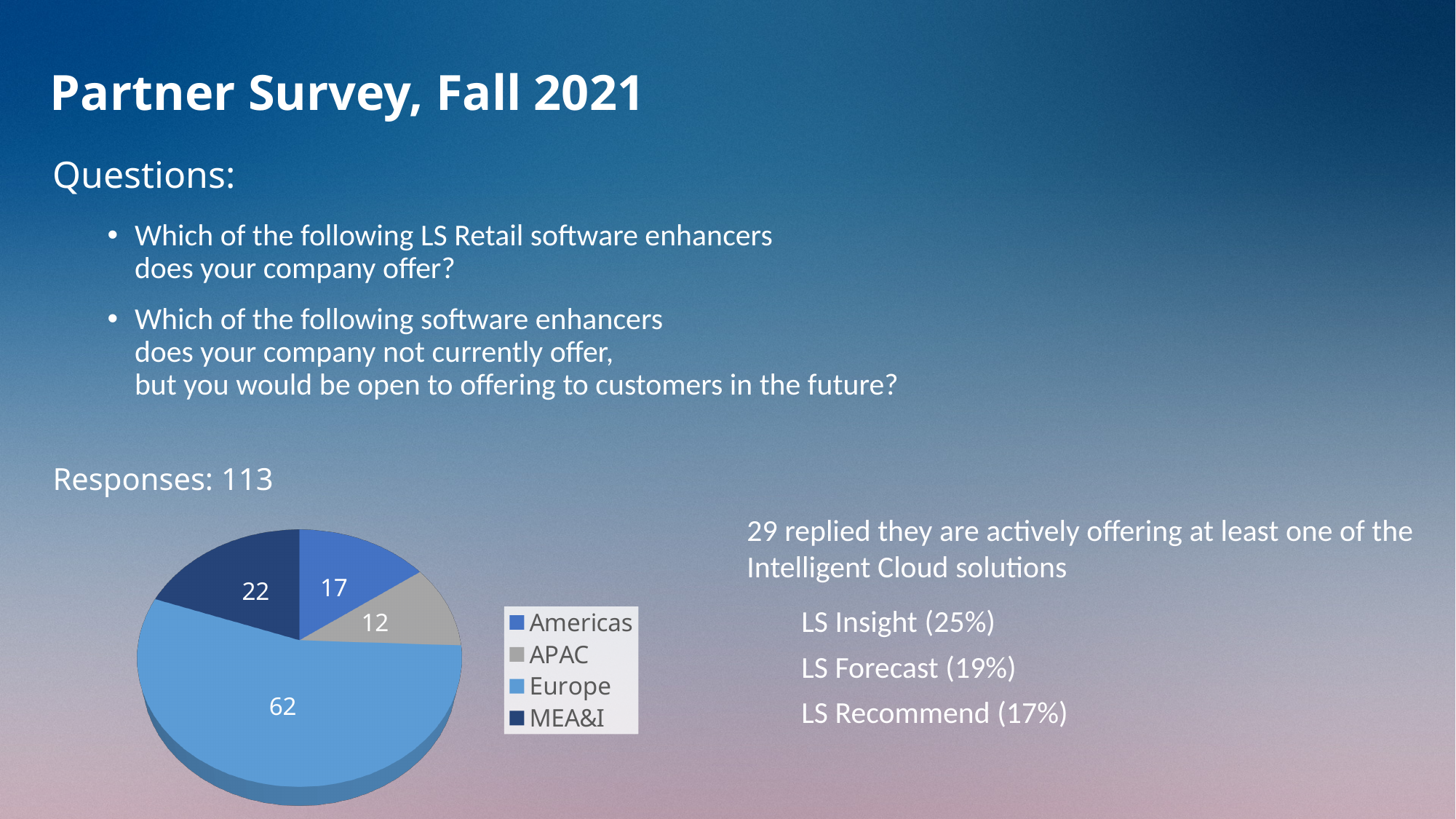
What type of chart is shown on the slide? pie chart How many slices does the pie chart have? 4 What is the value for Europe in the pie chart? 62 How many entries does the pie chart legend list? 4 What is the value for MEA&I in the pie chart? 22 Which region has the largest slice in the pie chart? Europe What is the value for APAC in the pie chart? 12 What is the total of all slices in the pie chart? 113 Which is larger in the pie chart, Americas or MEA&I? MEA&I Which region has the smallest slice in the pie chart? APAC What is the value for Americas in the pie chart? 17 What is the difference between the values for Europe and MEA&I in the pie chart? 40